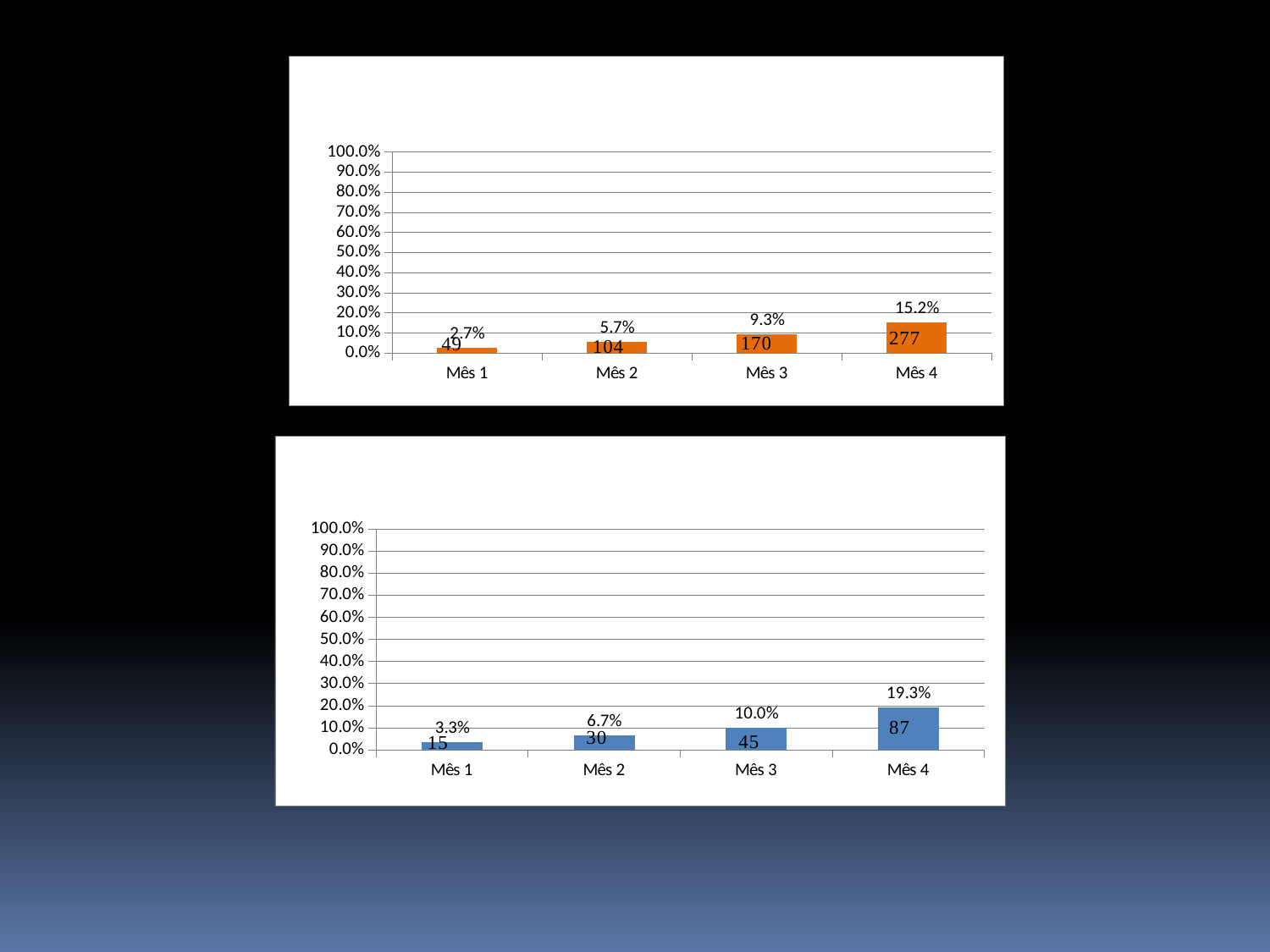
In the top chart, which month has the highest percentage? Mês 4 In the bottom chart, do the values rise or fall from Mês 1 to Mês 4? rise In the bottom chart, what number is printed inside the bar for Mês 4? 87 Which is larger: the Mês 4 percentage in the top chart or the Mês 4 percentage in the bottom chart? The bottom chart (19.3%) In the bottom chart, is the value for Mês 4 greater or less than 30%? less How many categories are shown on the x axis of the top chart? 4 In the top chart, what is the difference in percentage points between Mês 4 and Mês 3? 5.9 In the top chart, what is the percentage value shown for Mês 4? 15.2% In the bottom chart, what is the percentage value shown for Mês 2? 6.7% In the top chart, what number is printed inside the bar for Mês 3? 170 In the bottom chart, what is the difference between the counts printed for Mês 4 and Mês 1? 72 In the bottom chart, which month has the lowest percentage? Mês 1